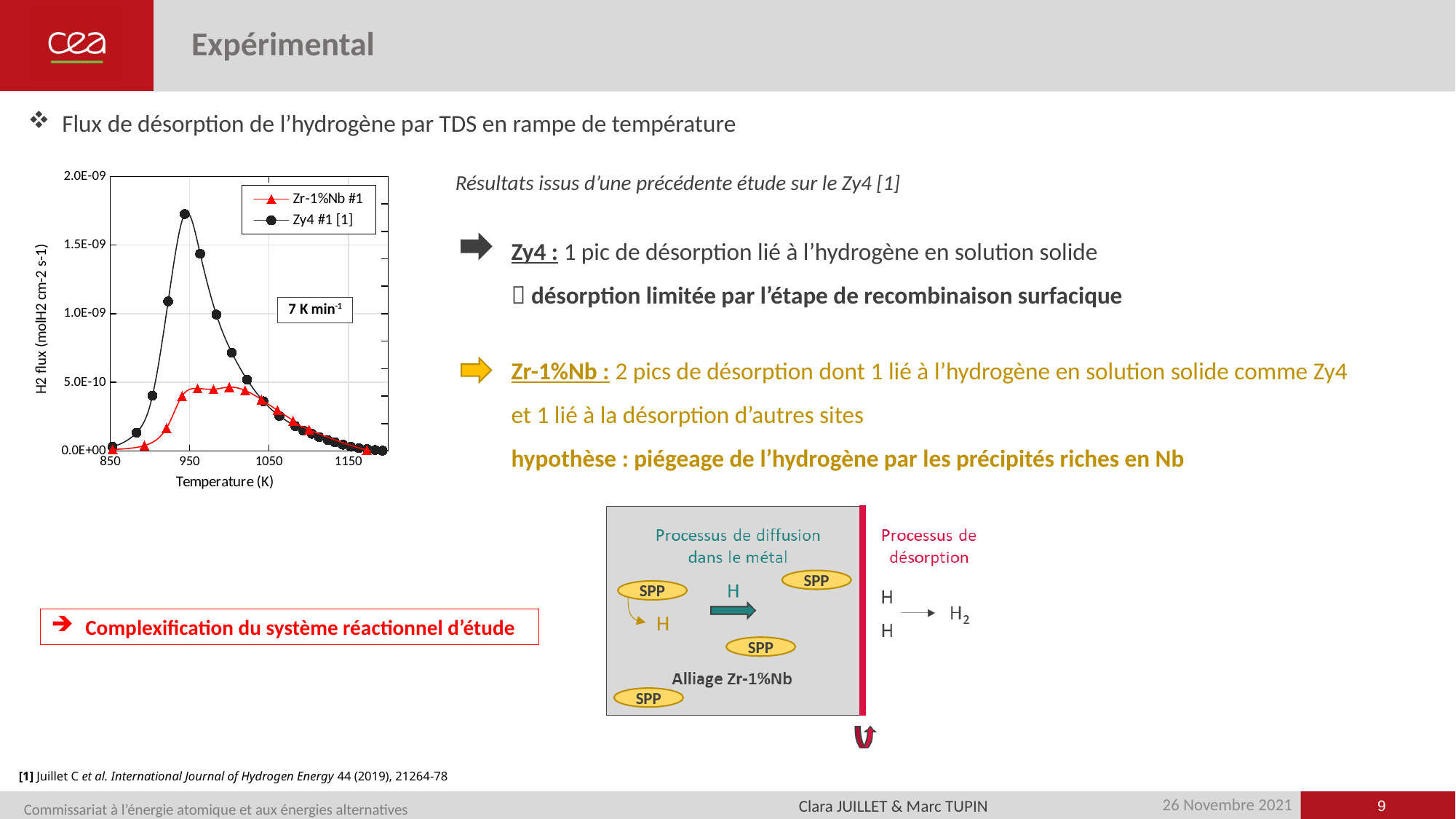
What is the title of the x axis of the chart? Temperature (K) How many series does the chart legend list? 2 What are the two series named in the chart legend? Zr-1%Nb #1 and Zy4 #1 [1] Which series reaches the higher peak H2 flux, Zr-1%Nb #1 or Zy4 #1 [1]? Zy4 #1 [1] Is the peak value of the Zy4 #1 [1] series greater or less than 1.5E-09? greater Is the value of the Zy4 #1 [1] series at 950 K greater or less than 1.0E-09? greater Does the H2 flux of the Zy4 #1 [1] series rise or fall between 950 K and 1150 K? fall What heating rate is annotated on the chart? 7 K min-1 What kind of chart is shown on the slide? line chart Does the H2 flux of the Zr-1%Nb #1 series rise or fall between 850 K and 950 K? rise Is the peak value of the Zy4 #1 [1] series greater or less than 2.0E-09? less